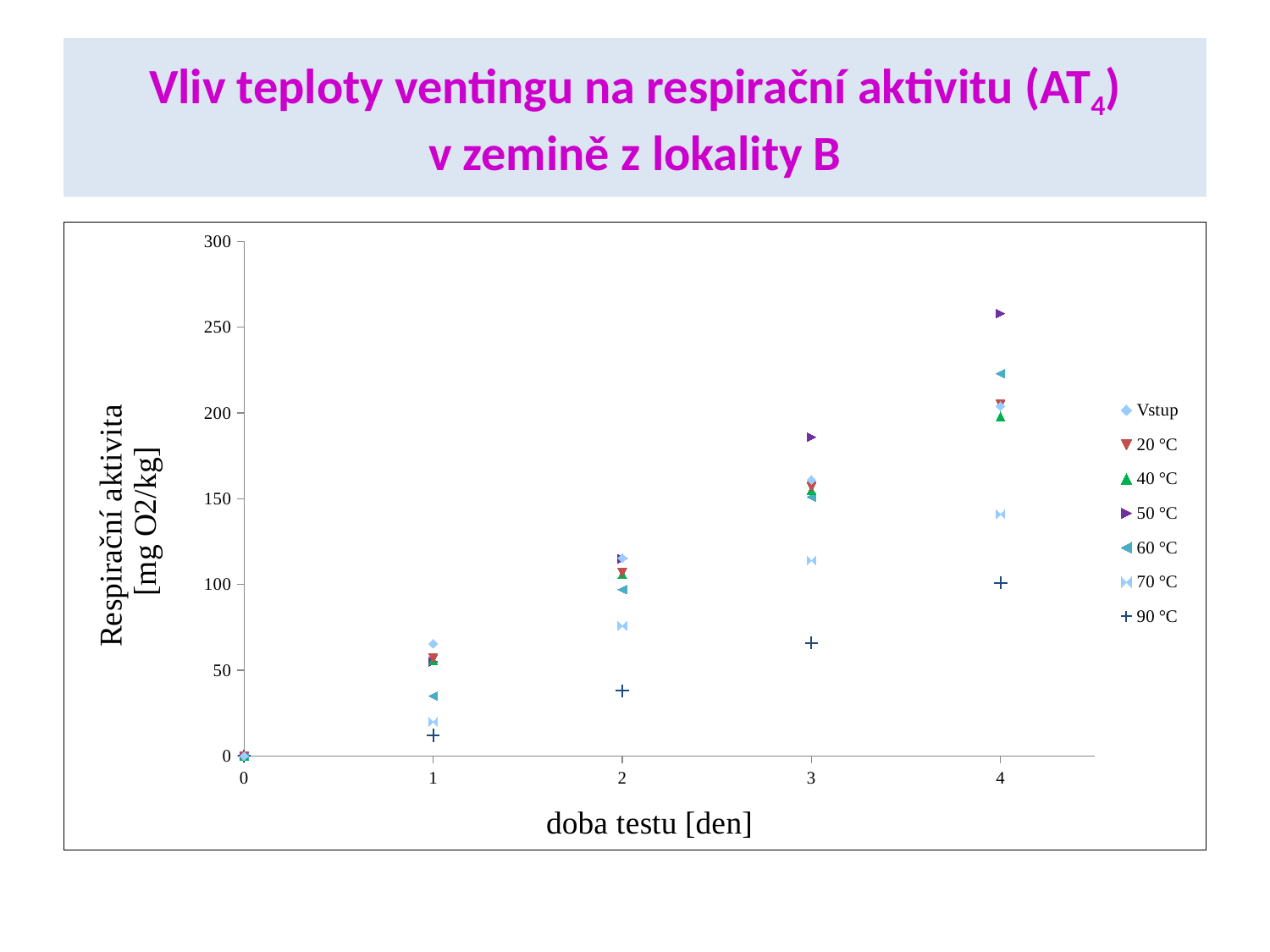
Is the value for the 90 °C series at day 4 greater or less than 150? less How many series does the legend list? 7 Do the values of the 90 °C series rise or fall as the test duration increases? rise At day 4, which series has the larger value: 60 °C or 70 °C? 60 °C What kind of chart is shown on the slide? scatter chart Is the value for the 90 °C series at day 2 greater or less than 50? less What is the title of the x axis? doba testu [den] How many time points (days) are plotted along the x axis for each series? 5 Which series has the highest respiration activity at day 4? 50 °C Is the value for the 70 °C series at day 3 greater or less than 100? greater Which series has the lowest respiration activity at day 4? 90 °C What is the title of the y axis? Respirační aktivita [mg O2/kg]